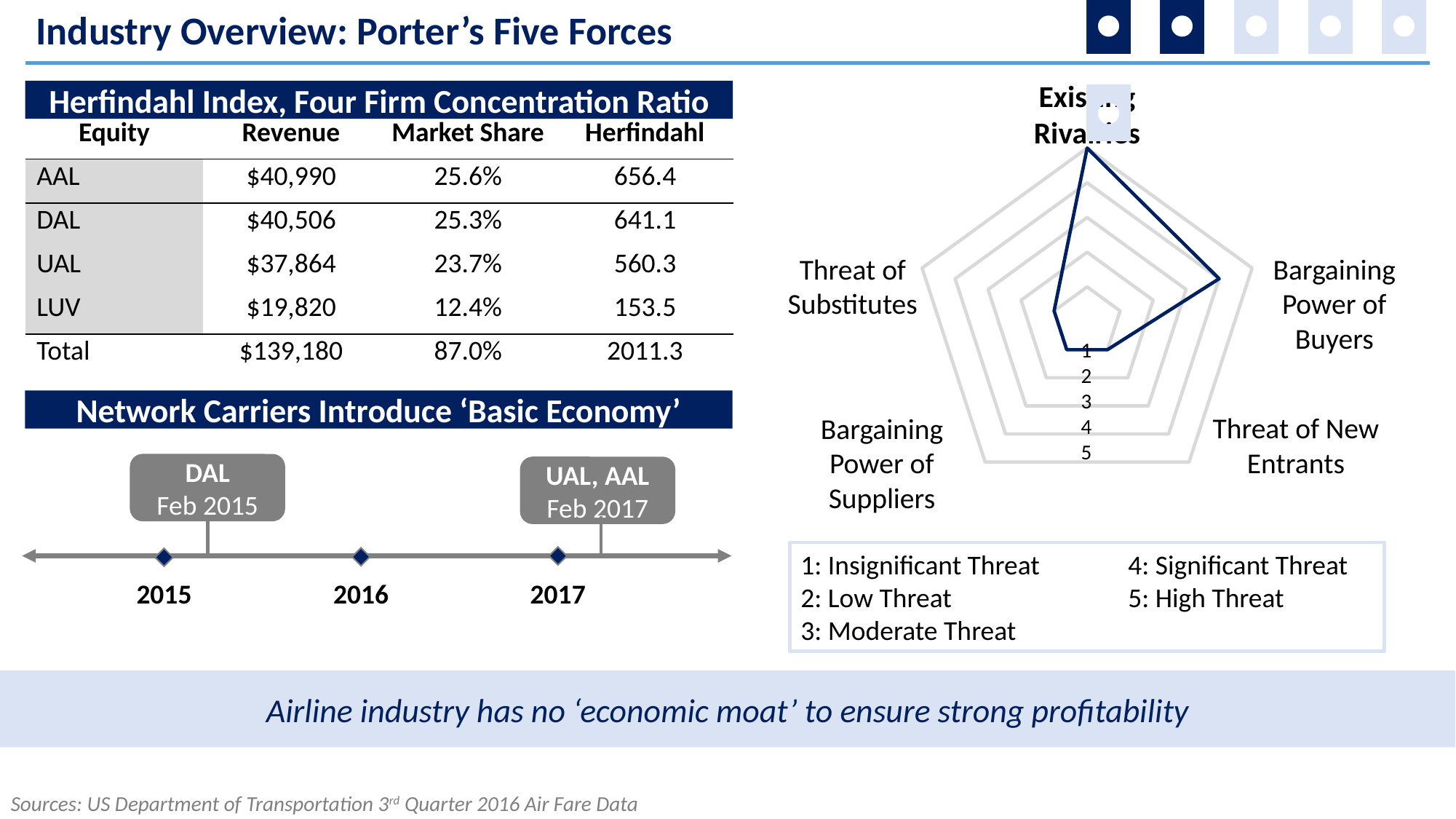
Which force has the highest value on the radar chart? Existing Rivalries On the radar chart, is the value for Threat of Substitutes greater or less than 2? less What value does the radar chart show for Bargaining Power of Buyers? 4 On the radar chart, which is larger: Bargaining Power of Buyers or Bargaining Power of Suppliers? Bargaining Power of Buyers On the radar chart, is the value for Threat of New Entrants greater or less than 3? less What value does the radar chart show for Existing Rivalries? 5 How many forces (categories) are plotted on the radar chart? 5 What kind of chart is shown on the right side of the slide? radar chart What is the highest value on the radar chart's scale? 5 On the radar chart, which is larger: Existing Rivalries or Threat of New Entrants? Existing Rivalries According to the key below the radar chart, what does a value of 3 represent? Moderate Threat On the radar chart, is the value for Bargaining Power of Suppliers greater or less than 2? less